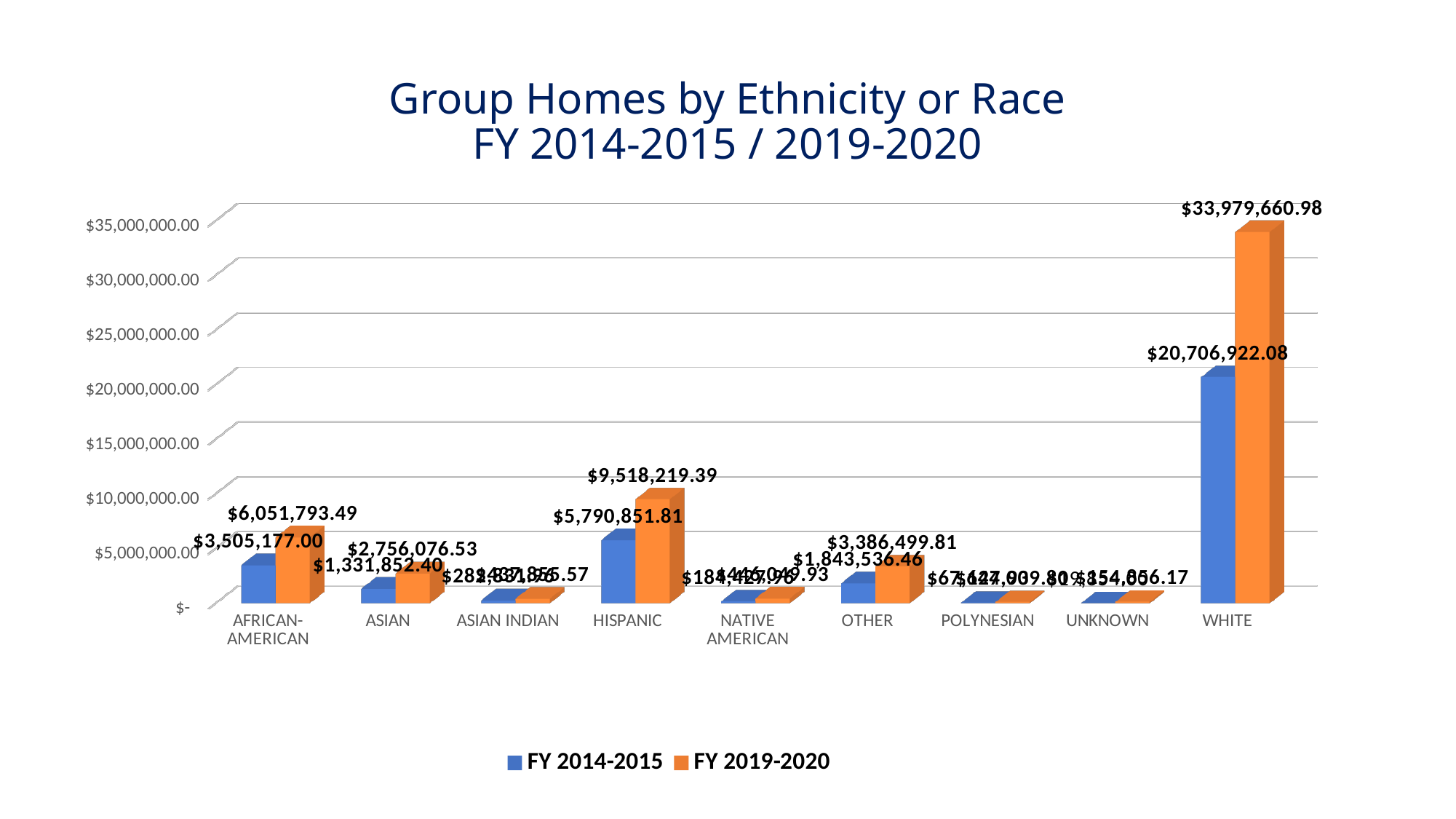
What is the FY 2019-2020 value for Other? $3,386,499.81 What is the FY 2014-2015 value for Asian? $1,331,852.40 What is the FY 2019-2020 value for African-American? $6,051,793.49 What is the difference between the FY 2019-2020 and FY 2014-2015 values for White? $13,272,738.90 Which is larger, the FY 2014-2015 value for Hispanic or the FY 2014-2015 value for African-American? Hispanic Is the FY 2019-2020 value for White greater or less than $30,000,000.00? greater Which category has the highest FY 2019-2020 value? White What is the FY 2019-2020 value for White? $33,979,660.98 What is the difference between the FY 2019-2020 and FY 2014-2015 values for Hispanic? $3,727,367.58 How many series does the legend list? 2 What is the FY 2014-2015 value for Hispanic? $5,790,851.81 What kind of chart is shown on the slide? Bar chart